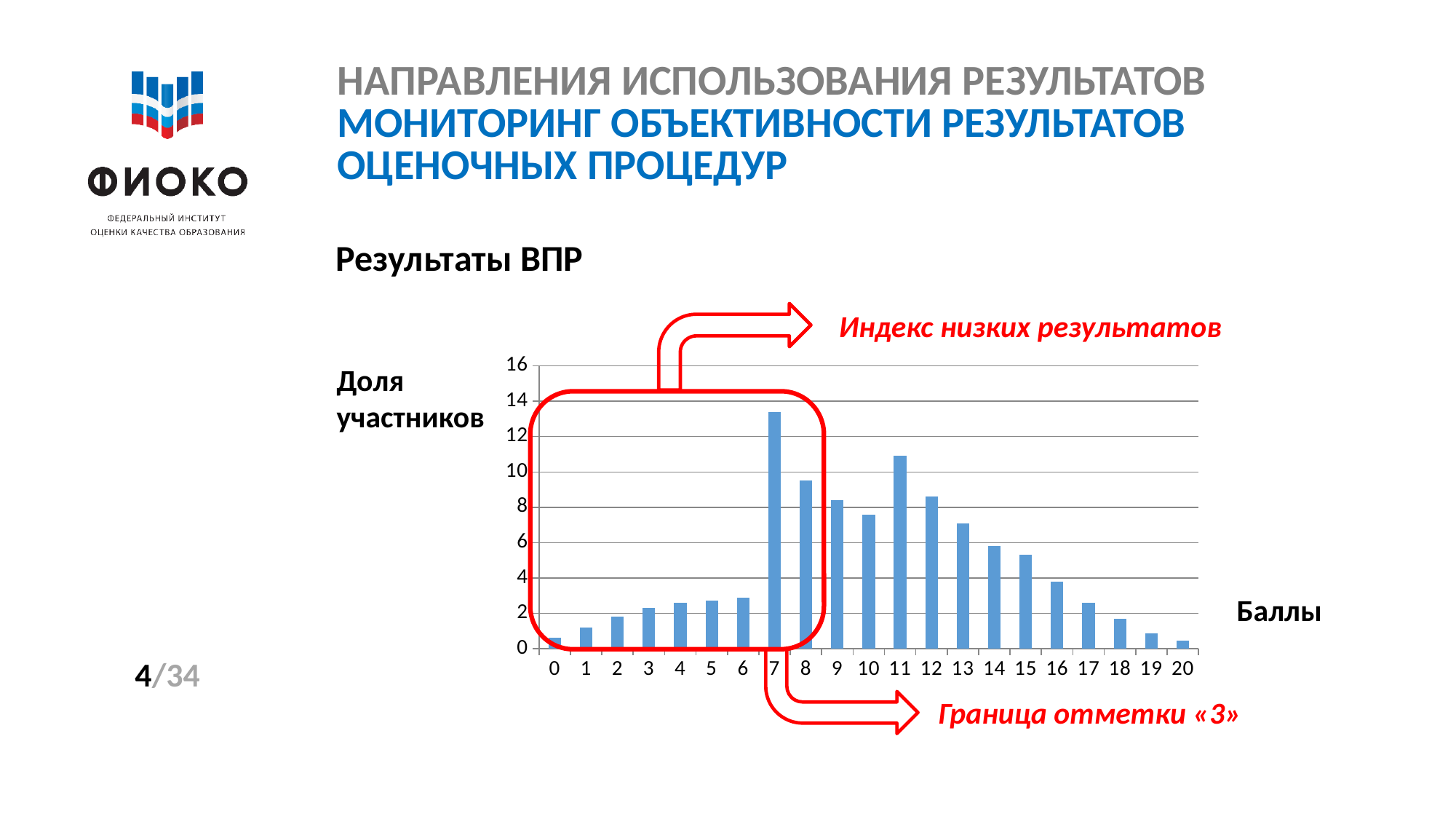
Which has a larger share of participants, score 8 or score 9? 8 How many score categories are shown along the x axis of the chart? 21 Do the values rise or fall as the score increases from 0 to 6? rise Which has a larger share of participants, score 7 or score 11? 7 What is the label of the x axis of the chart? Баллы What kind of chart is shown on the slide? bar chart Is the value for score 7 greater or less than 12? greater Is the value for score 11 greater or less than 10? greater Do the values rise or fall as the score increases from 11 to 20? fall Which score has the highest share of participants? 7